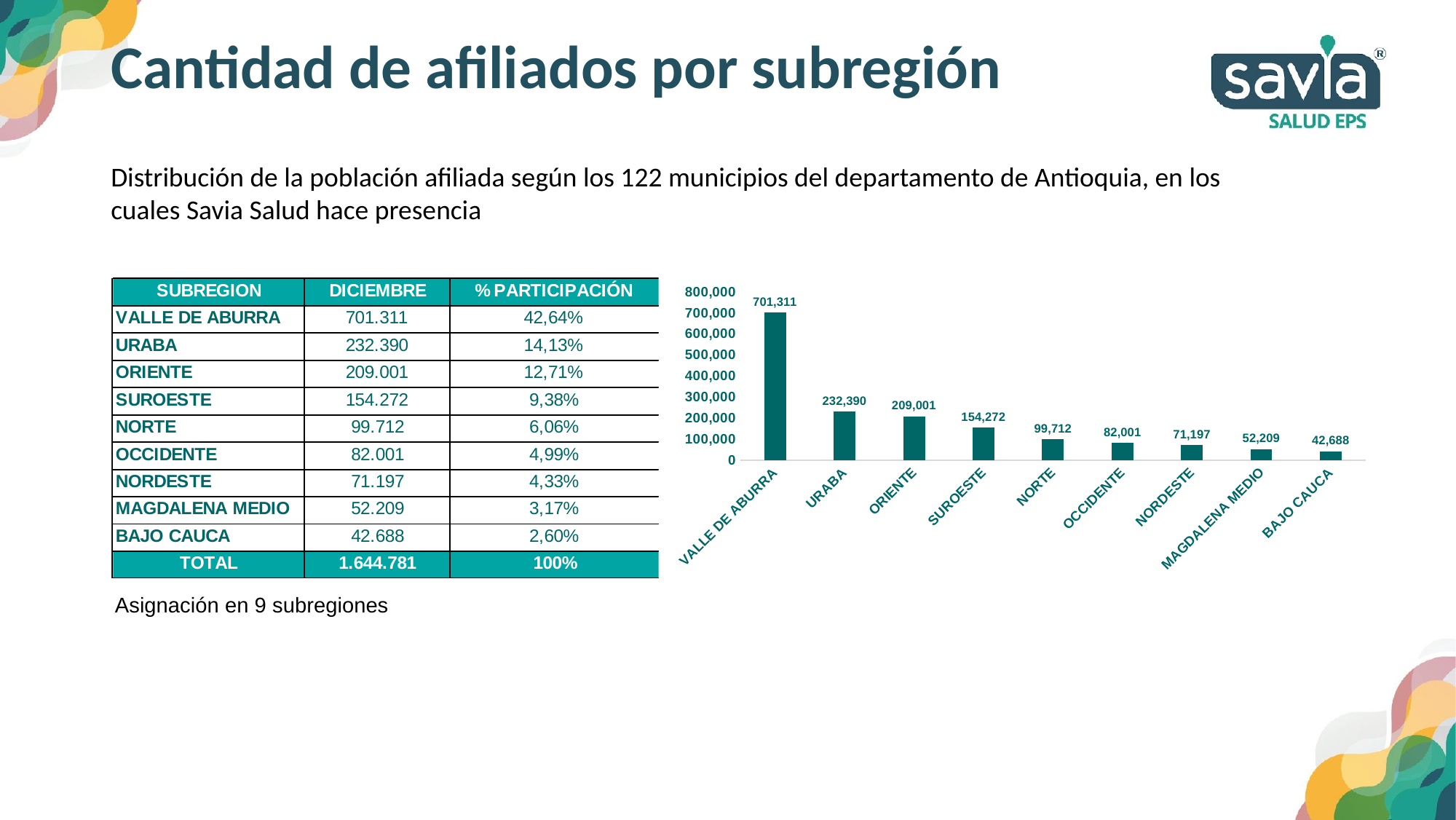
What is the value for VALLE DE ABURRA in the bar chart? 701,311 Which is larger in the bar chart, the value for NORTE or the value for OCCIDENTE? NORTE Which subregion has the highest value in the bar chart? VALLE DE ABURRA What is the value for SUROESTE in the bar chart? 154,272 Is the value for ORIENTE in the bar chart greater or less than 300,000? less What is the difference between the values for URABA and ORIENTE in the bar chart? 23,389 Which subregion has the lowest value in the bar chart? BAJO CAUCA What kind of chart is shown on the slide? bar chart What is the value for MAGDALENA MEDIO in the bar chart? 52,209 How many subregions are shown in the bar chart? 9 Do the values in the bar chart rise or fall from left to right along the x axis? fall What is the difference between the values for NORDESTE and BAJO CAUCA in the bar chart? 28,509